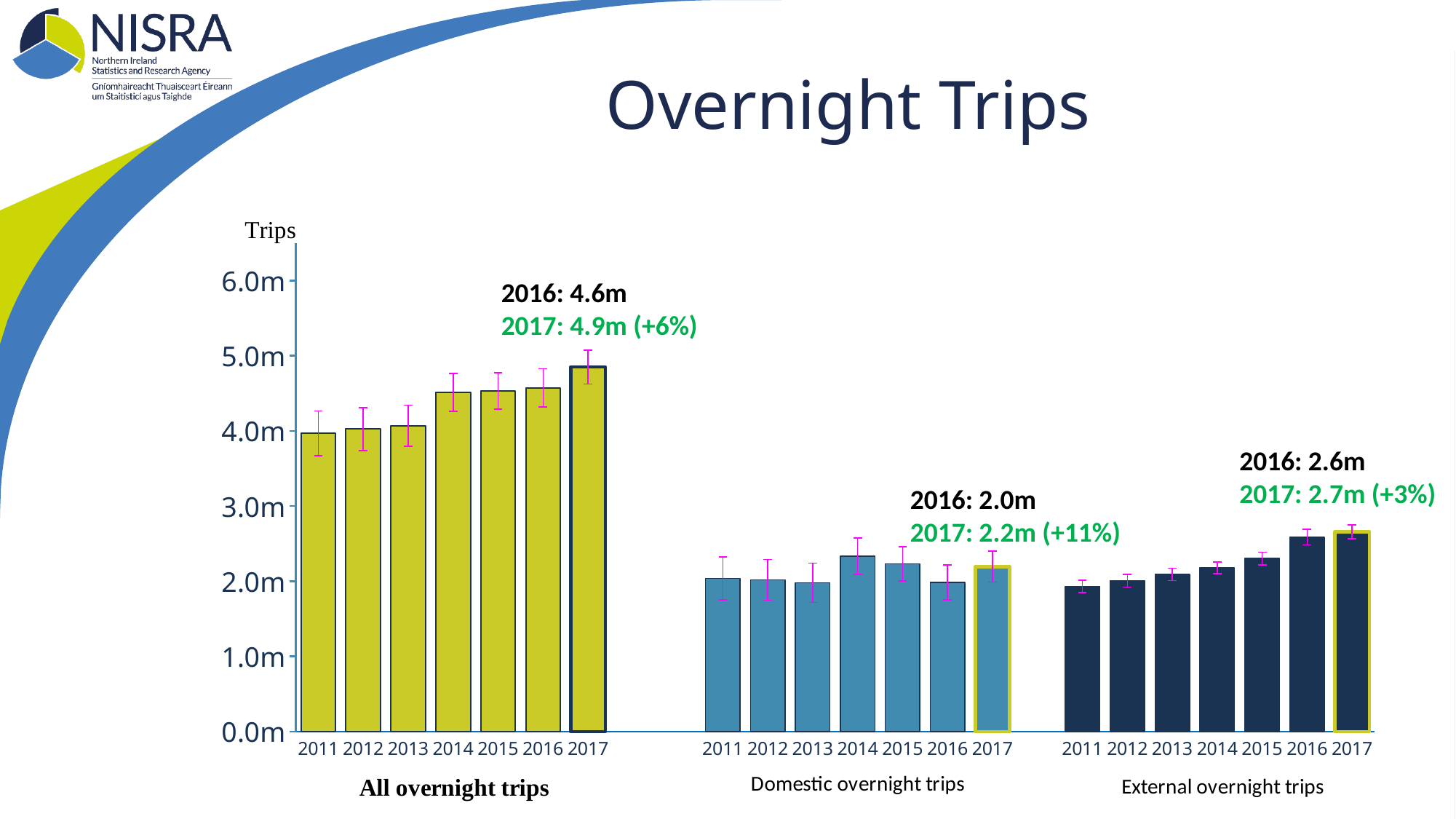
What is the difference between All overnight trips in 2017 and in 2016? 0.3m What is the value for Domestic overnight trips in 2016? 2.0m Which year has the highest value for All overnight trips? 2017 What type of chart is shown on the slide? bar chart How many years are shown for each group of overnight trips? 7 Is the value for All overnight trips in 2011 greater or less than 3.0m? greater What percentage change is shown for Domestic overnight trips from 2016 to 2017? +11% What is the value for External overnight trips in 2017? 2.7m Do the values for External overnight trips rise or fall from 2011 to 2017? rise Which is larger in 2017: Domestic overnight trips or External overnight trips? External overnight trips Which year has the lowest value for External overnight trips? 2011 What is the value for All overnight trips in 2017? 4.9m